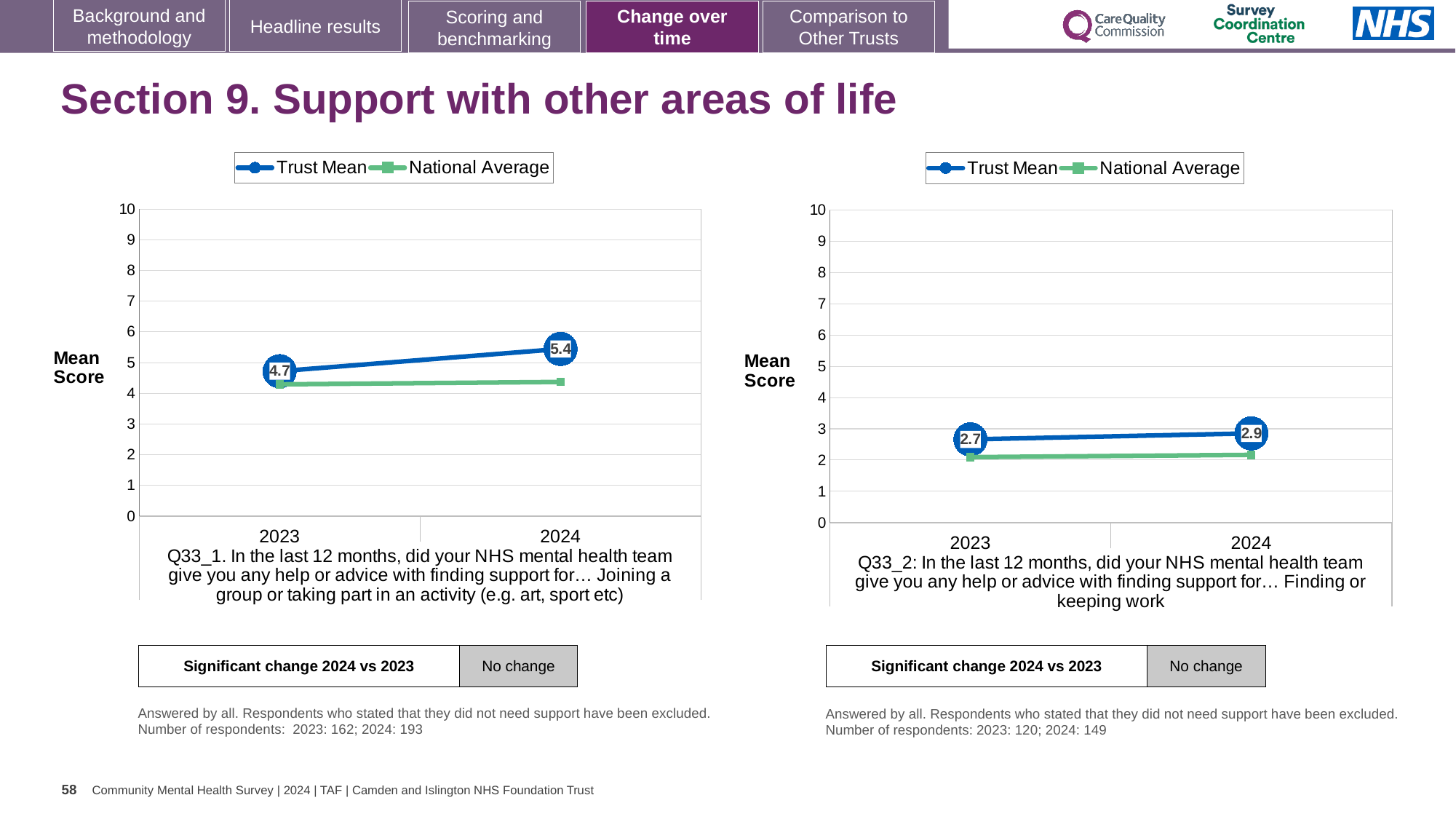
In the right chart (Q33_2, finding or keeping work), what is the Trust Mean for 2023? 2.7 In the left chart (Q33_1), by how much did the Trust Mean change from 2023 to 2024? 0.7 In the right chart (Q33_2, finding or keeping work), what is the Trust Mean for 2024? 2.9 What type of chart is the left chart (Q33_1)? line chart In the left chart (Q33_1, joining a group or taking part in an activity), what is the Trust Mean for 2024? 5.4 In the left chart (Q33_1, joining a group or taking part in an activity), what is the Trust Mean for 2023? 4.7 In the right chart (Q33_2), what is the difference between the Trust Mean in 2024 and in 2023? 0.2 In the left chart (Q33_1), is the National Average for 2023 greater or less than 5? less How many series does the legend of the right chart (Q33_2) list? 2 In the left chart (Q33_1), does the Trust Mean rise or fall from 2023 to 2024? rise In the right chart (Q33_2), is the National Average for 2024 greater or less than 3? less In the left chart (Q33_1), which is larger in 2024, the Trust Mean or the National Average? Trust Mean